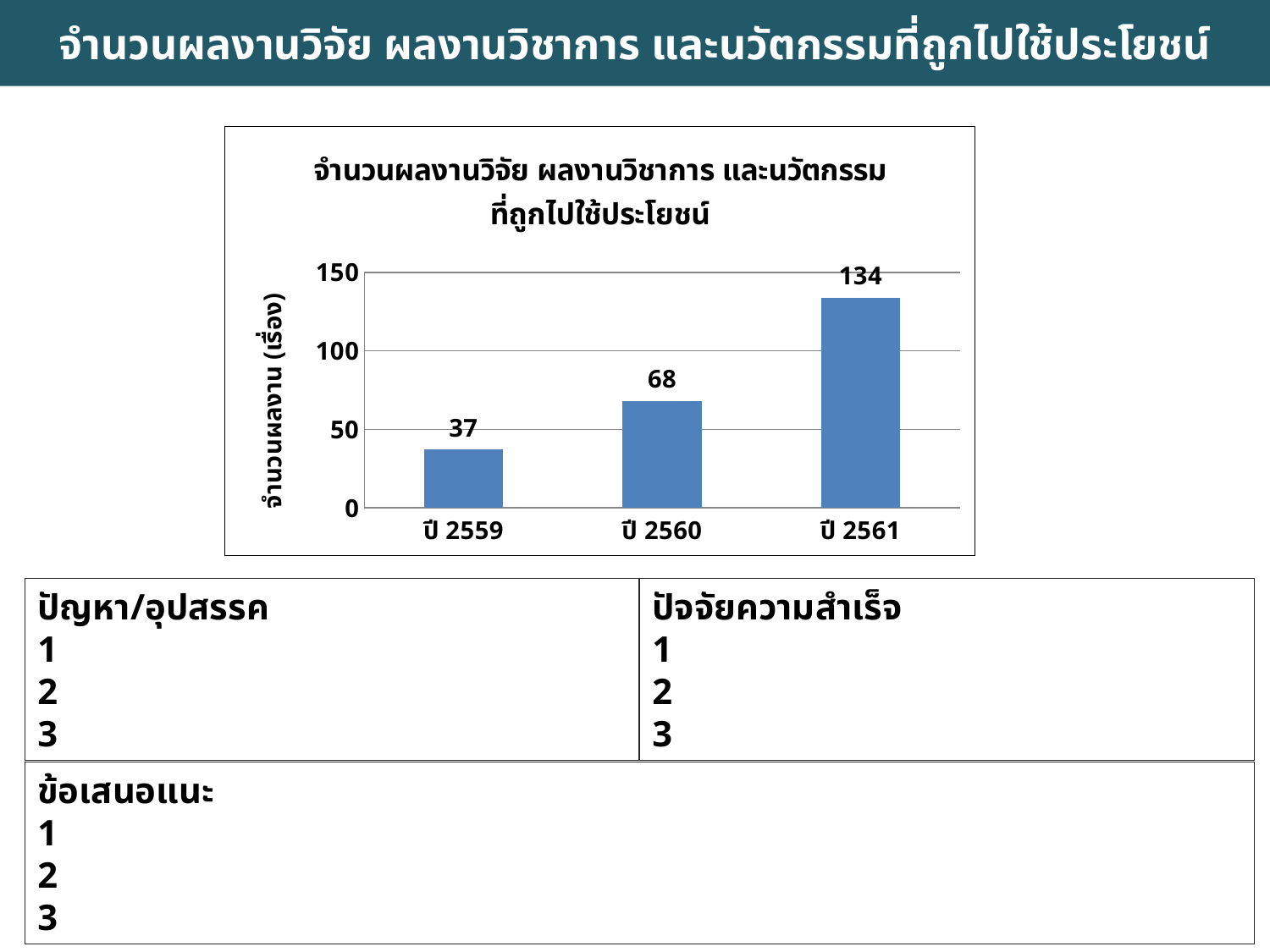
What kind of chart is shown? bar chart What is the value for ปี 2559? 37 How many years are shown on the x axis? 3 What is the value for ปี 2560? 68 What is the value for ปี 2561? 134 Which year has the highest value? ปี 2561 What is the difference between the values for ปี 2561 and ปี 2560? 66 Which year has the lowest value? ปี 2559 Is the value for ปี 2561 greater or less than 100? greater Do the values rise or fall from ปี 2559 to ปี 2561? rise Which is larger, the value for ปี 2559 or ปี 2560? ปี 2560 What is the difference between the values for ปี 2560 and ปี 2559? 31